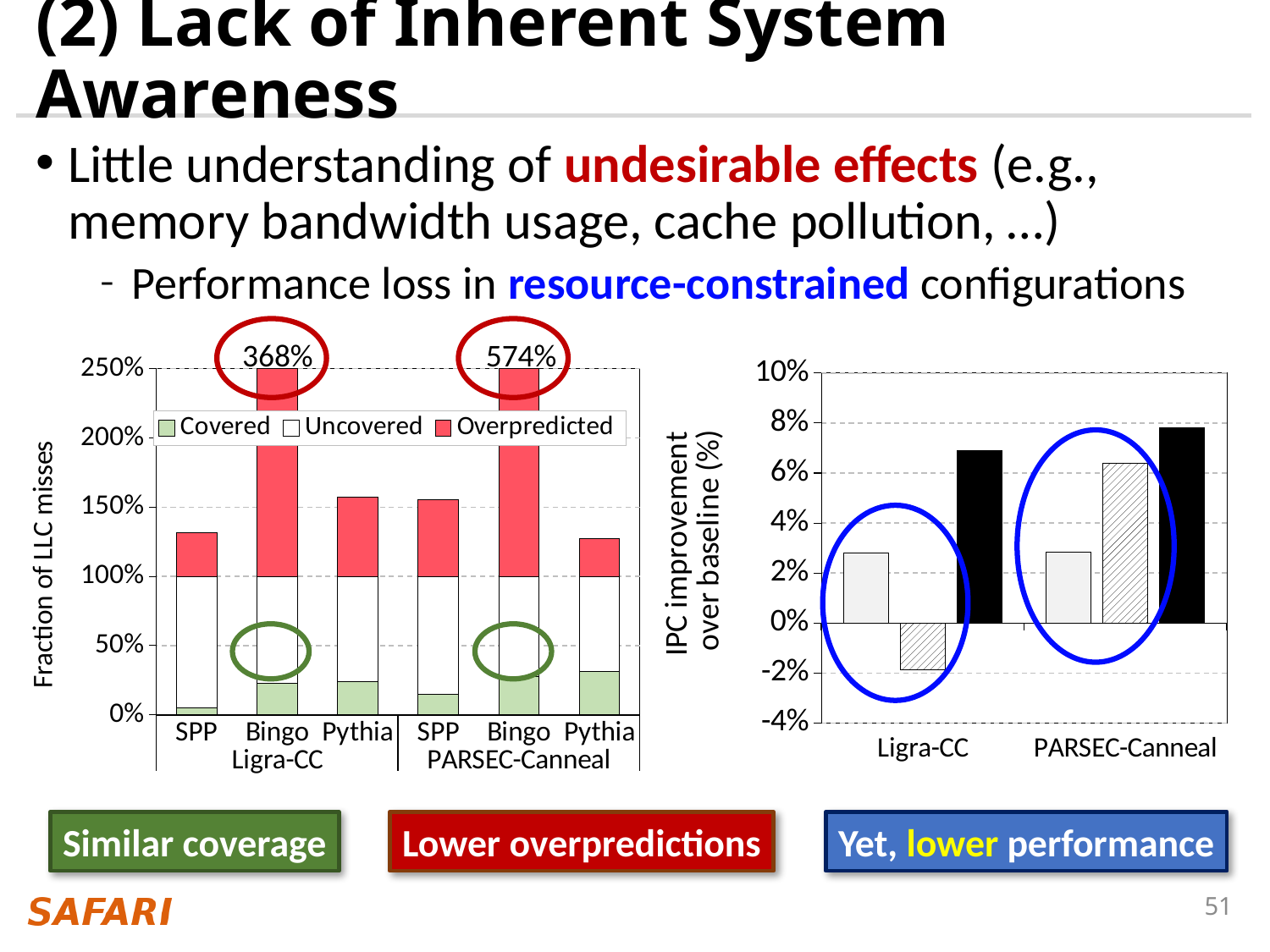
In the left chart (Fraction of LLC misses), how many series does the legend list? 3 In the right chart (IPC improvement over baseline), how many categories are shown on the x axis? 2 In the left chart (Fraction of LLC misses), what value is labelled on the Bingo bar for Ligra-CC? 368% In the left chart (Fraction of LLC misses), is the total for the SPP bar under Ligra-CC greater or less than 150%? less What kind of chart is the left chart (Fraction of LLC misses)? Stacked bar chart What is the y-axis label of the right chart? IPC improvement over baseline (%) In the left chart (Fraction of LLC misses), what value is labelled on the Bingo bar for PARSEC-Canneal? 574% In the left chart (Fraction of LLC misses), which is larger: the Bingo bar for Ligra-CC or the Bingo bar for PARSEC-Canneal? Bingo for PARSEC-Canneal In the right chart (IPC improvement over baseline), is the value of the hatched bar for Ligra-CC greater or less than 0%? less In the left chart (Fraction of LLC misses), how many stacked bars are plotted? 6 In the left chart (Fraction of LLC misses), what is the difference between the labelled Bingo values for PARSEC-Canneal and Ligra-CC? 206% In the left chart (Fraction of LLC misses), which bar is the highest? Bingo for PARSEC-Canneal